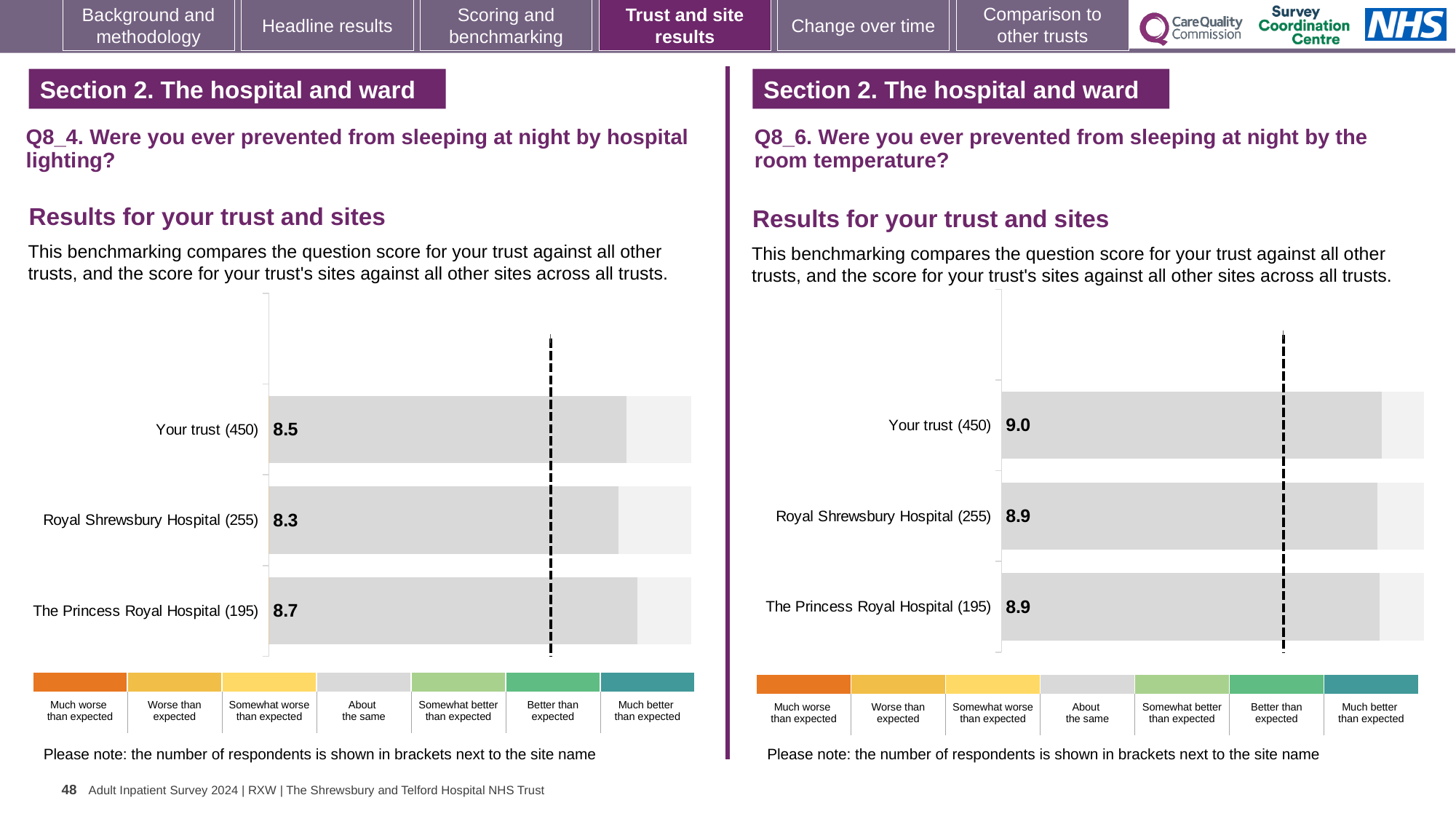
In the Q8_4 chart (hospital lighting) on the left, which site or trust has the highest score? The Princess Royal Hospital (195) In the Q8_6 chart (room temperature) on the right, what is the difference between the scores for Your trust and Royal Shrewsbury Hospital? 0.1 In the Q8_4 chart (hospital lighting) on the left, which site or trust has the lowest score? Royal Shrewsbury Hospital (255) In the Q8_4 chart (hospital lighting) on the left, what is the score for Your trust (450)? 8.5 In the Q8_4 chart (hospital lighting) on the left, what is the difference between the scores for The Princess Royal Hospital and Royal Shrewsbury Hospital? 0.4 In the Q8_6 chart (room temperature) on the right, what is the score for The Princess Royal Hospital (195)? 8.9 In the Q8_4 chart (hospital lighting) on the left, what is the score for Royal Shrewsbury Hospital (255)? 8.3 In the Q8_6 chart (room temperature) on the right, what is the score for Your trust (450)? 9.0 In the Q8_6 chart (room temperature) on the right, which bar has the highest score? Your trust (450) How many bars are plotted in the Q8_4 chart (hospital lighting) on the left? 3 Which score is larger: Your trust in the Q8_4 chart (hospital lighting) or Your trust in the Q8_6 chart (room temperature)? Q8_6 (room temperature) What type of chart is used for the Q8_6 results (room temperature) on the right? Bar chart